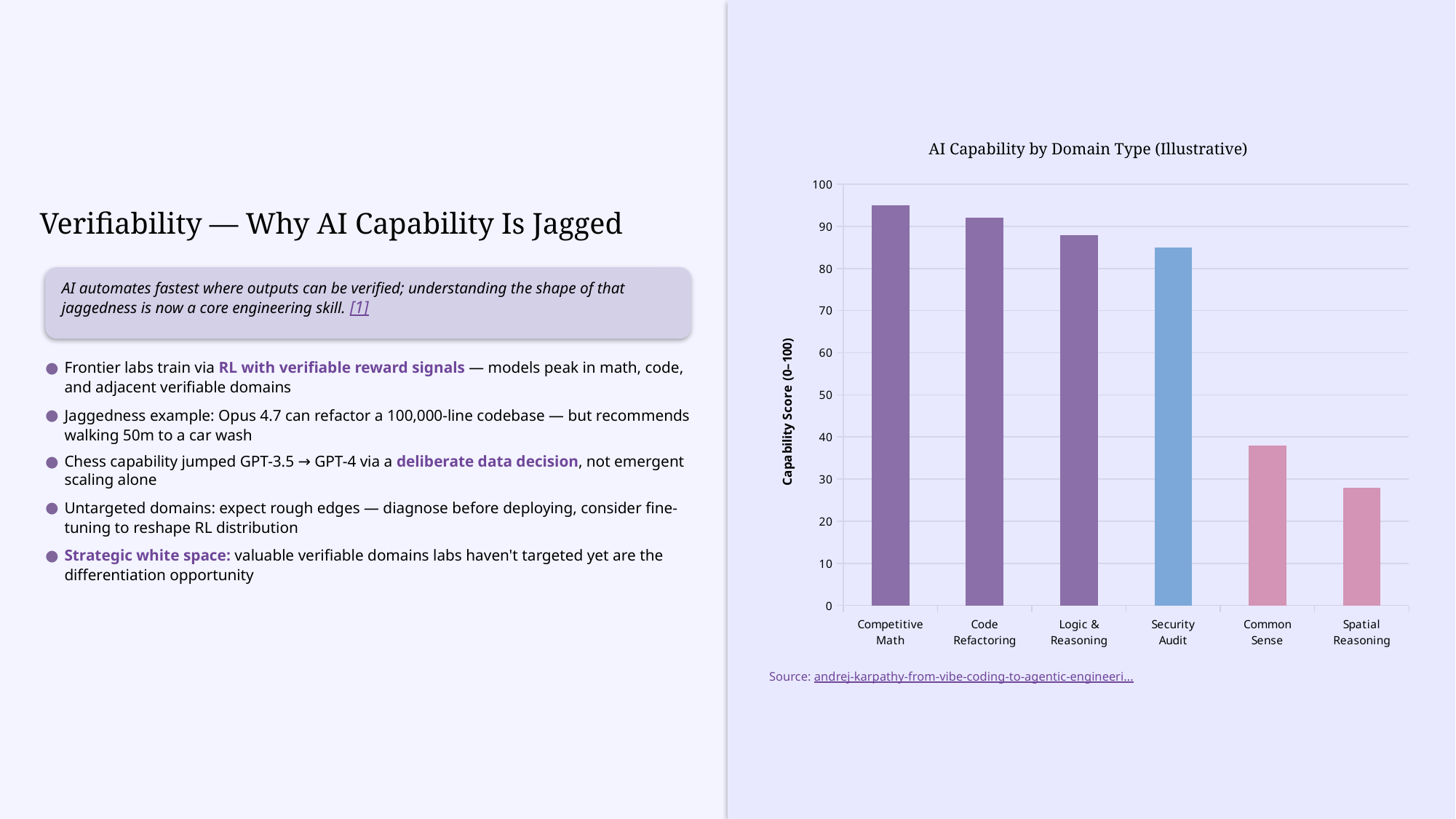
Do the capability scores rise or fall moving from left to right across the categories? fall How many domain categories are plotted in the chart? 6 What is the title of the chart? AI Capability by Domain Type (Illustrative) Is the value for Spatial Reasoning greater or less than 30? less Which has a higher capability score, Common Sense or Spatial Reasoning? Common Sense What is the label on the vertical axis of the chart? Capability Score (0–100) Is the value for Competitive Math greater or less than 90? greater Which domain has the highest capability score? Competitive Math What type of chart is shown on the slide? bar chart Is the value for Common Sense greater or less than 40? less Which domain has the lowest capability score? Spatial Reasoning